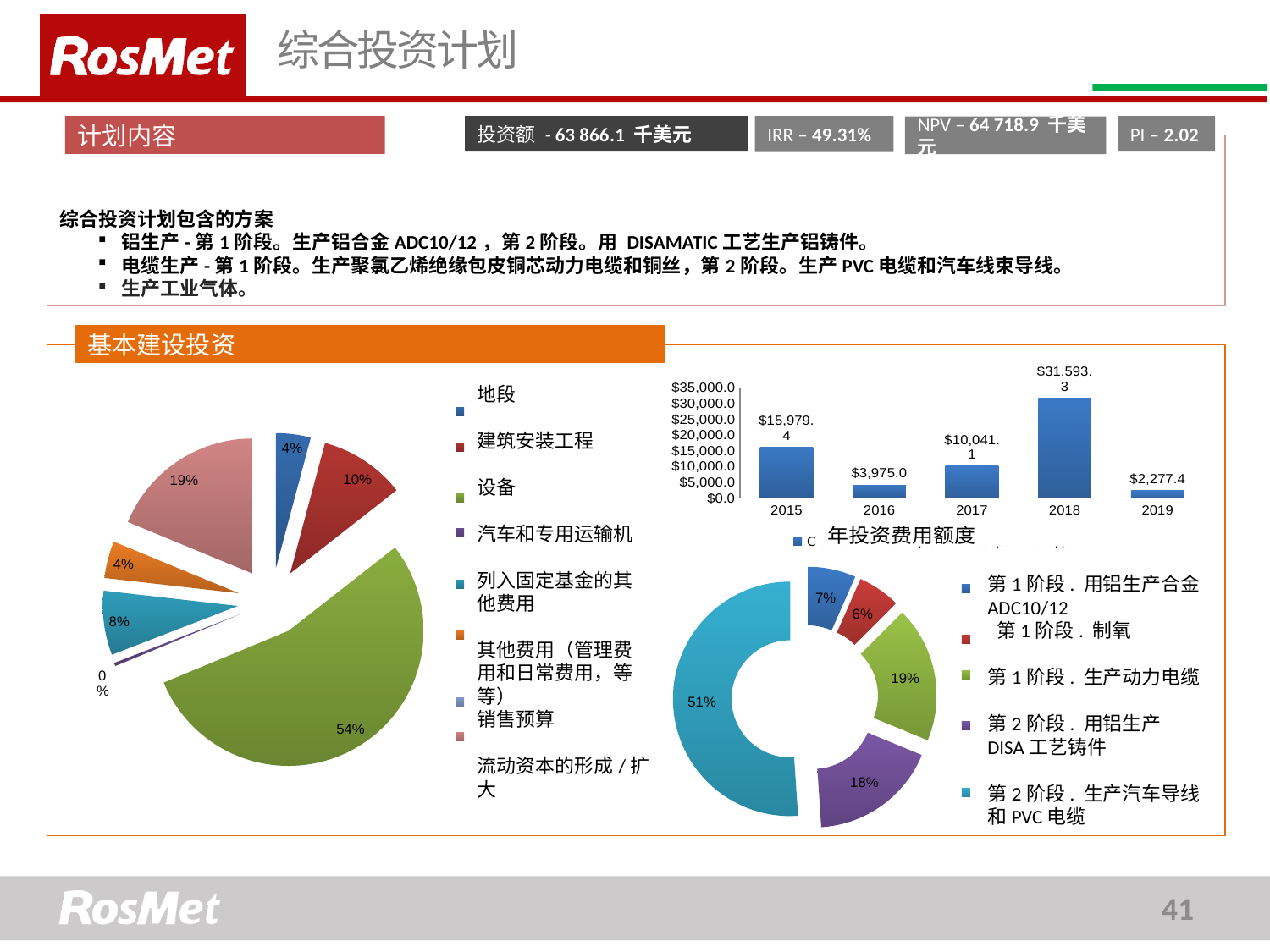
In the pie chart on the left of the slide, which category has the largest share? 设备 In the bar chart 年投资费用额度, what is the value for 2016? $3,975.0 In the bar chart 年投资费用额度, which year has the highest value? 2018 In the pie chart on the left of the slide, what share does 设备 have? 54% In the bar chart 年投资费用额度, what is the difference between the 2018 and 2015 values? $15,613.9 In the donut chart at the bottom right of the slide, what share does 第 2 阶段 . 生产汽车导线和 PVC 电缆 have? 51% In the bar chart 年投资费用额度, which year has the lowest value? 2019 In the donut chart at the bottom right of the slide, which is larger: 第 1 阶段 . 生产动力电缆 or 第 1 阶段 . 制氧? 第 1 阶段 . 生产动力电缆 In the bar chart 年投资费用额度, how many years are shown on the x axis? 5 In the pie chart on the left of the slide, what share does 建筑安装工程 have? 10% In the bar chart 年投资费用额度, is the value for 2017 greater or less than $15,000.0? less In the bar chart 年投资费用额度, what is the value for 2018? $31,593.3